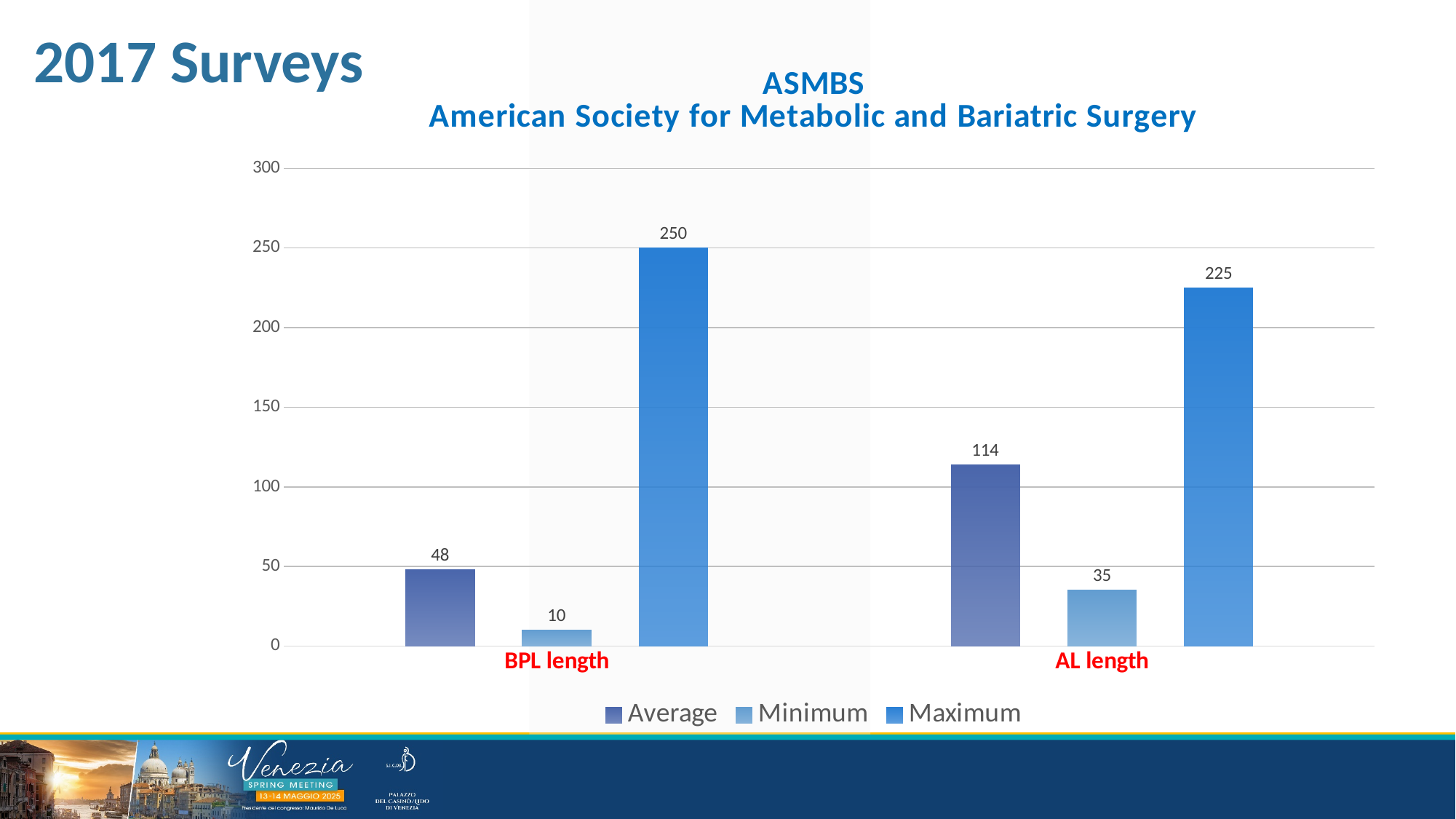
What is the Average value for AL length? 114 What kind of chart is shown on the slide? Bar chart How many categories are shown on the x axis? 2 Which category has the higher Maximum value, BPL length or AL length? BPL length What is the Maximum value for AL length? 225 What is the difference between the Average values for AL length and BPL length? 66 How many series does the legend list? 3 What is the Minimum value for BPL length? 10 Which series has the lowest value for AL length? Minimum What is the title of the chart? ASMBS American Society for Metabolic and Bariatric Surgery What is the Average value for BPL length? 48 What is the difference between the Maximum and Minimum values for BPL length? 240